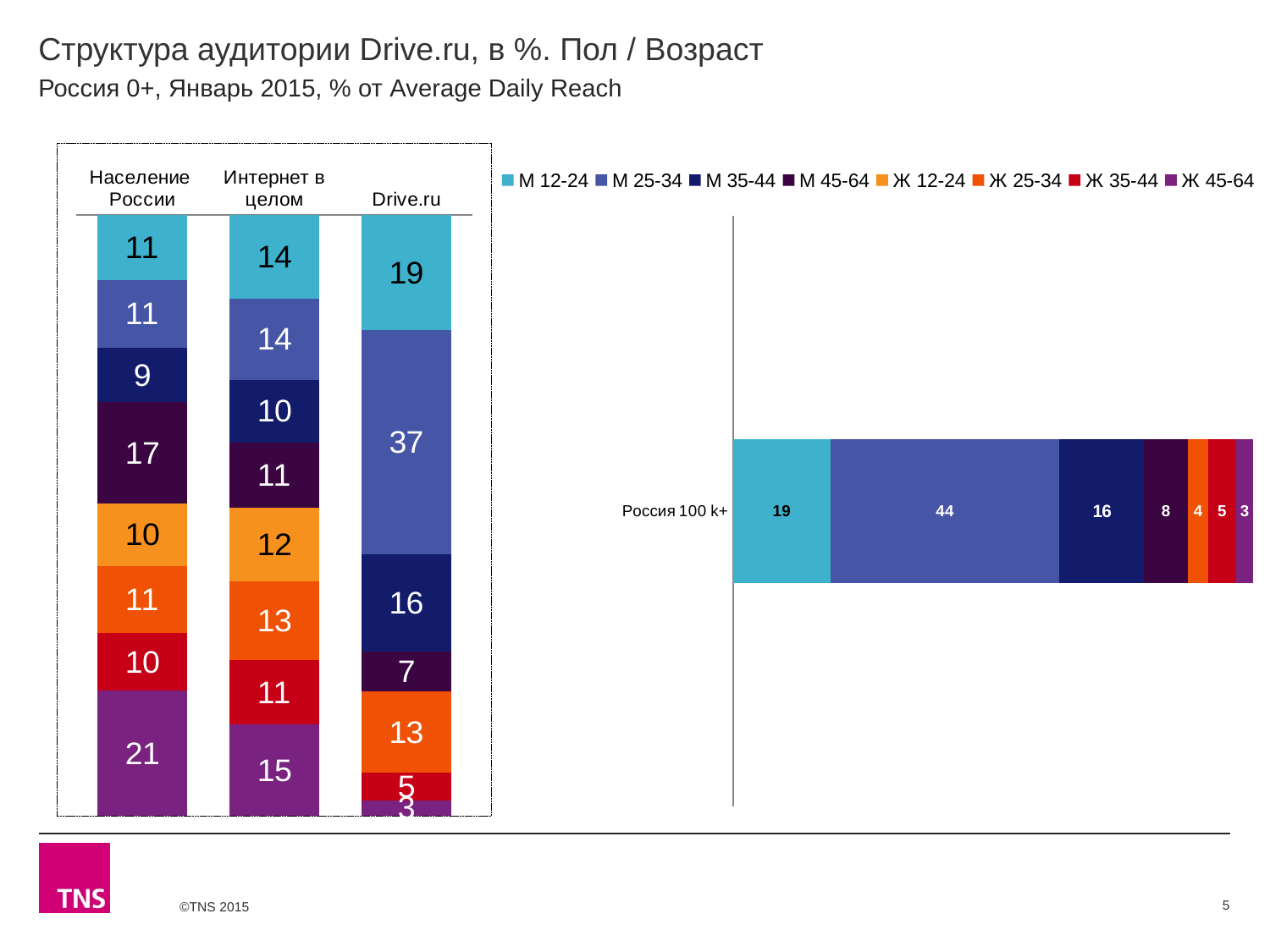
In the left chart, what is the value of the М 45-64 segment for Интернет в целом? 11 In the right chart, what is the value of the М 35-44 segment for Россия 100 k+? 16 In the left chart, which has a larger М 12-24 value: Интернет в целом or Население России? Интернет в целом In the right chart, what is the value of the М 25-34 segment for Россия 100 k+? 44 How many series does the legend list? 8 In the left chart, what is the value of the М 12-24 segment for Drive.ru? 19 In the left chart, what is the value of the Ж 45-64 segment for Население России? 21 How many categories are shown in the left chart? 3 What kind of chart is the right chart? Stacked bar chart In the left chart, what is the value of the М 25-34 segment for Drive.ru? 37 In the left chart, which category has the largest М 25-34 segment? Drive.ru In the left chart, what is the difference between the М 12-24 values for Drive.ru and Население России? 8